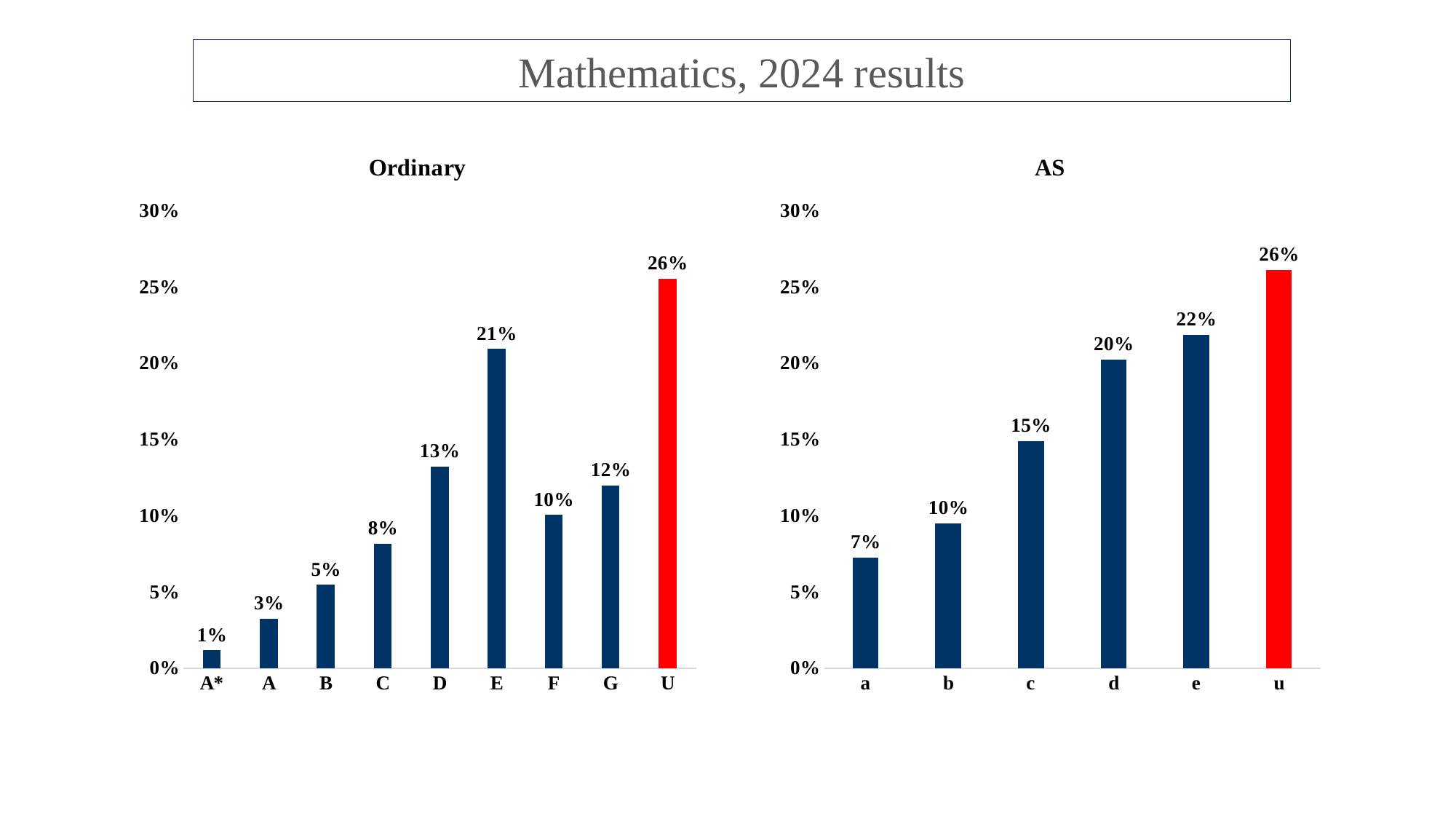
In the Ordinary chart, which grade has the highest value? U How many grade categories are shown in the AS chart? 6 What type of chart is the AS chart? Bar chart In the AS chart, which grade has the lowest value? a In the Ordinary chart, what is the value for grade E? 21% In the AS chart, what is the value for grade c? 15% In the AS chart, do the values rise or fall from grade a to grade u? Rise How many grade categories are shown in the Ordinary chart? 9 In the AS chart, what is the difference between the values for grade u and grade e? 4% In the Ordinary chart, which grade has the lowest value? A* In the Ordinary chart, which is larger, the value for grade F or the value for grade G? G In the Ordinary chart, what is the difference between the values for grade E and grade D? 8%